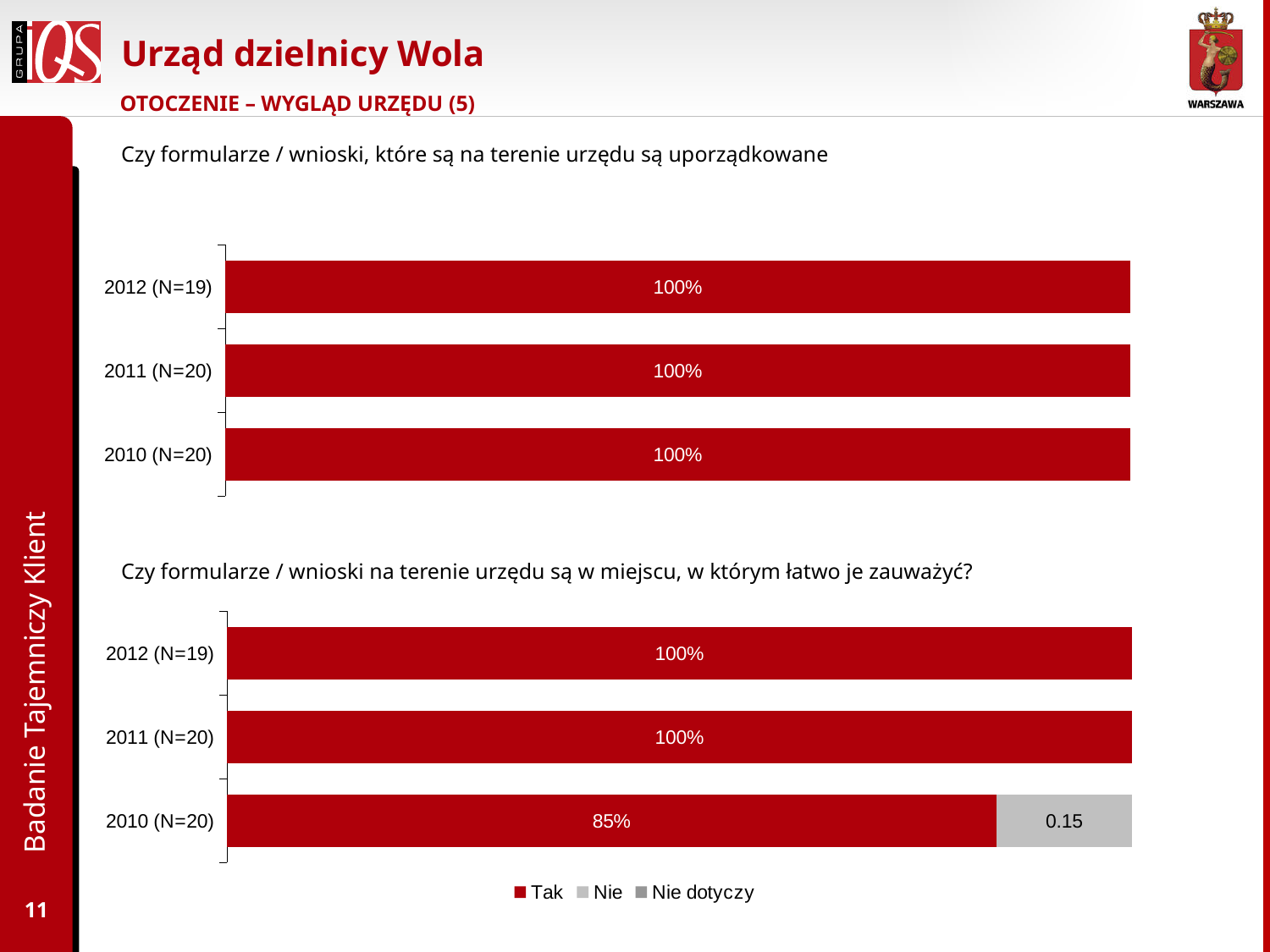
In the bottom chart, what is the 'Tak' value for 2011 (N=20)? 100% In the bottom chart, what is the 'Nie' value for 2010 (N=20)? 0.15 What type of chart is the bottom chart? bar chart In the bottom chart, is the 'Tak' value for 2012 (N=19) larger or smaller than the 'Tak' value for 2010 (N=20)? larger In the top chart, what is the value for 2010 (N=20)? 100% In the bottom chart, what is the 'Tak' value for 2010 (N=20)? 85% How many series does the legend at the bottom of the slide list? 3 In the bottom chart, what is the difference between the 'Tak' value for 2012 (N=19) and the 'Tak' value for 2010 (N=20)? 15% In the top chart, what is the value for 2012 (N=19)? 100% What are the legend entries shown below the bottom chart? Tak, Nie, Nie dotyczy How many categories (years) are shown in the top chart? 3 In the bottom chart, which year has the lowest 'Tak' value? 2010 (N=20)